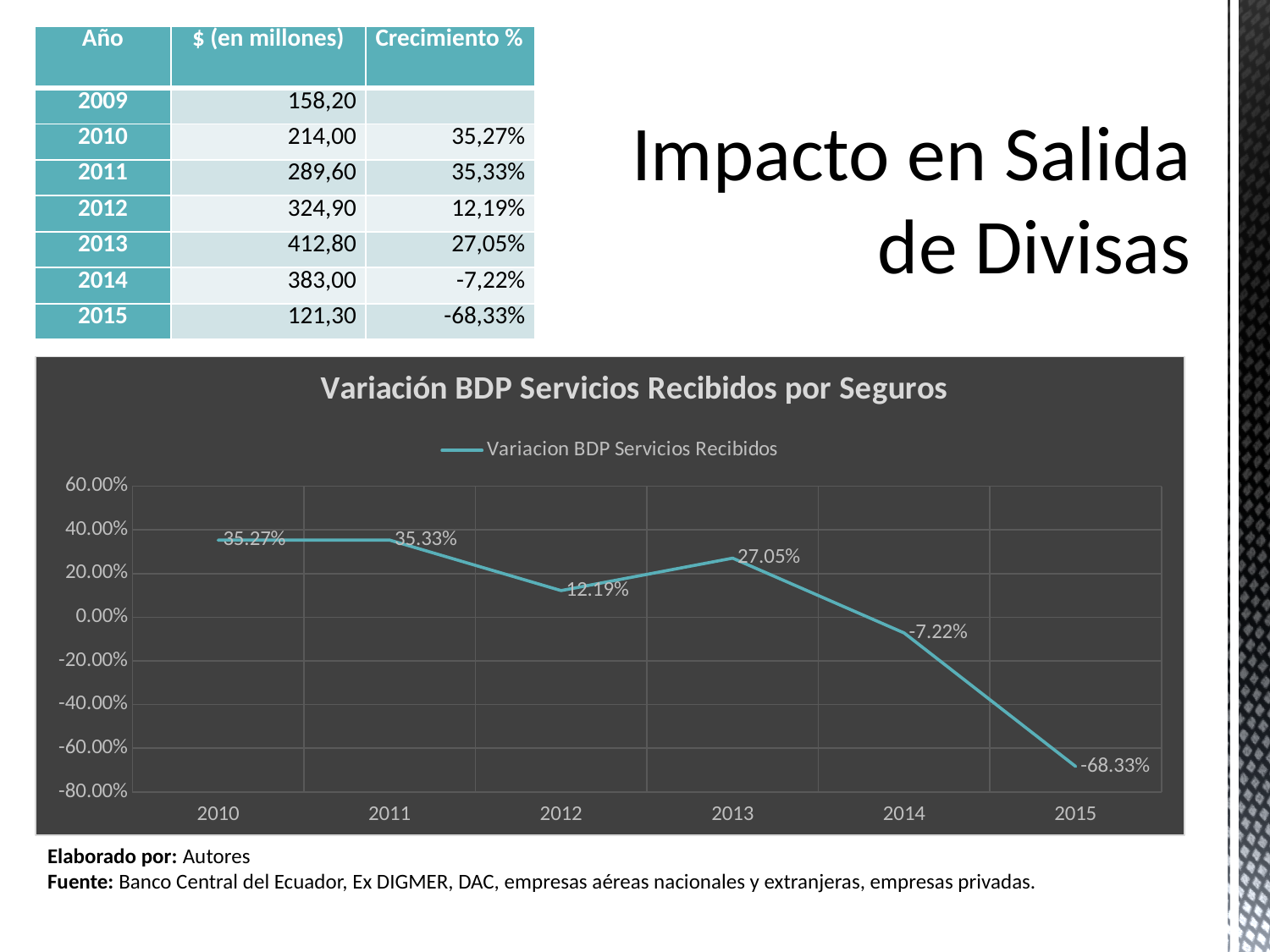
What is the difference between the values for 2013 and 2012 in the chart? 14.86 percentage points What kind of chart is shown on the slide? line chart What is the value for 2013 in the chart? 27.05% What is the value for 2014 in the chart? -7.22% Which is larger in the chart, the value for 2012 or the value for 2013? 2013 What is the title of the chart? Variación BDP Servicios Recibidos por Seguros Is the value for 2014 in the chart greater or less than 0.00%? less Which year has the lowest value in the chart? 2015 What is the value for 2012 in the chart? 12.19% How many years are plotted on the x axis of the chart? 6 How many series does the chart legend list? 1 What is the value for 2015 in the chart? -68.33%